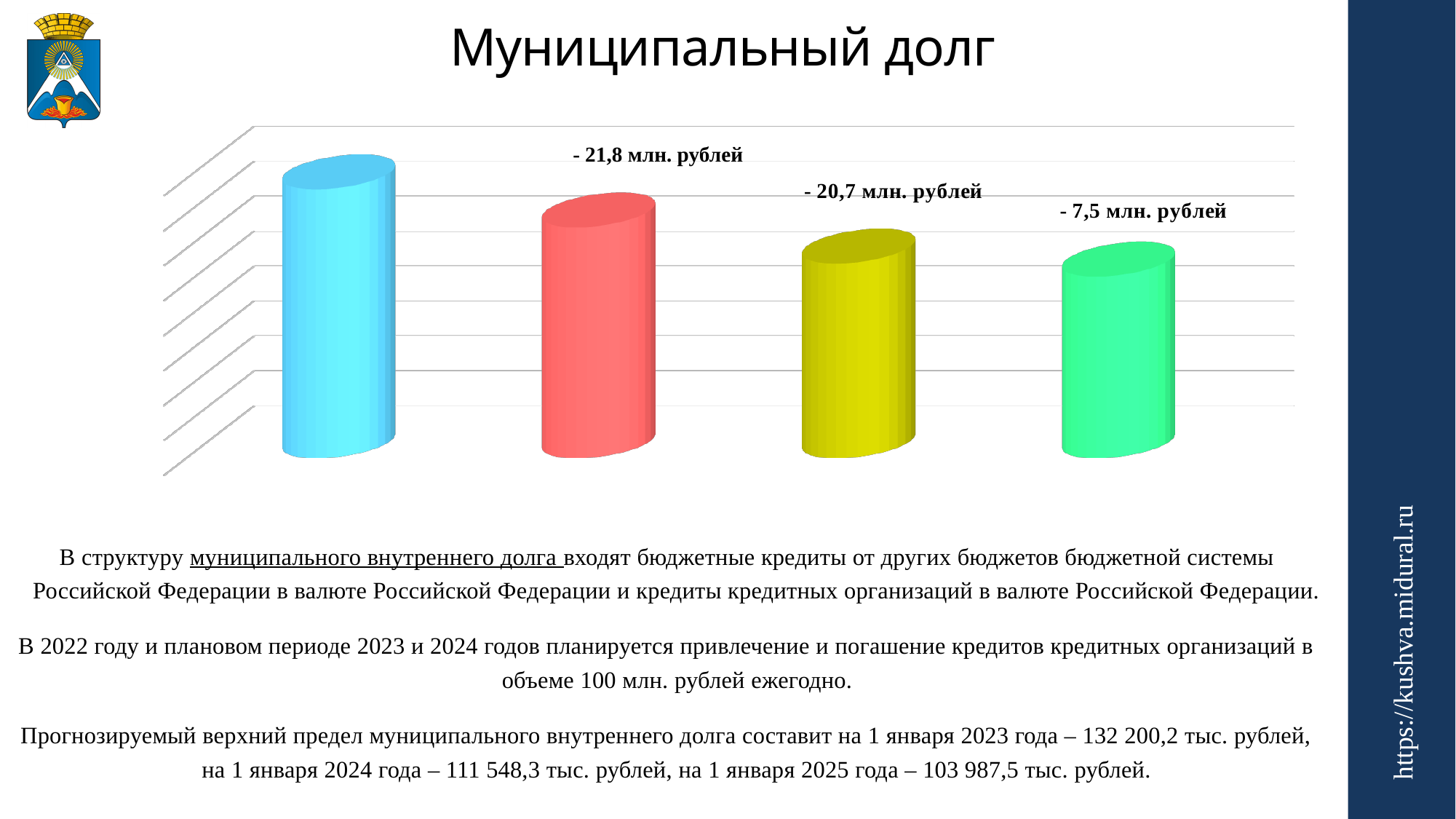
Which bar is the tallest in the chart? the first (blue) bar Which bar is the shortest in the chart? the last (green) bar What label is printed above the yellow (third) bar? - 20,7 млн. рублей What is the title of the slide containing the chart? Муниципальный долг What kind of chart is shown on the slide? bar chart What label is printed above the red (second) bar? - 21,8 млн. рублей How many bars does the chart contain? 4 Which is taller, the blue bar or the green bar? the blue bar Which is taller, the red bar or the yellow bar? the red bar What label is printed above the green (fourth) bar? - 7,5 млн. рублей Do the bar heights rise or fall from left to right across the chart? fall What colour is the first bar in the chart? blue